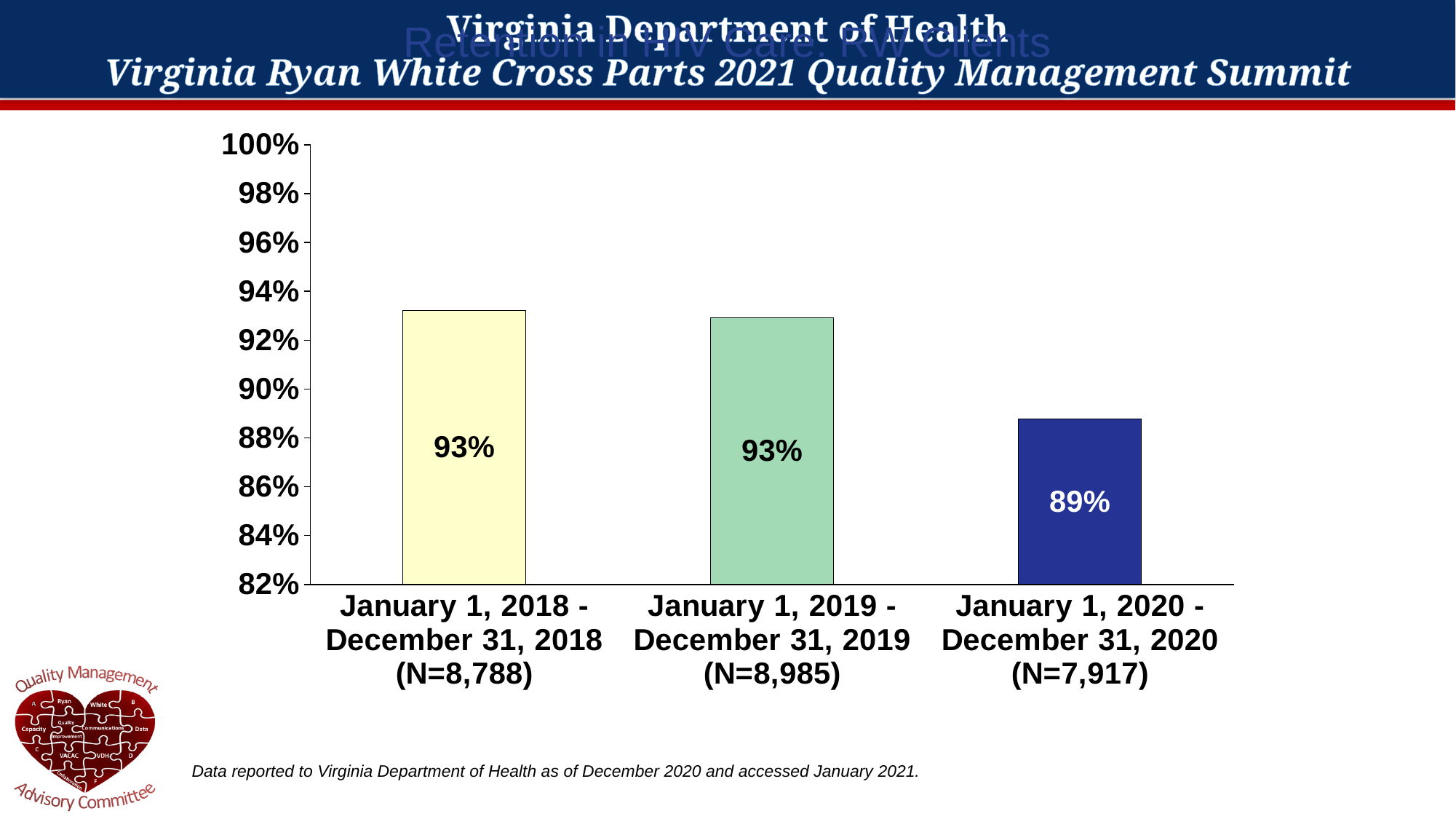
Do the values rise or fall from the 2019 period to the 2020 period? fall Which is larger, the value for the 2019 period or the value for the 2020 period? January 1, 2019 - December 31, 2019 (N=8,985) What colour is the bar for the 2020 period? dark blue What is the value for January 1, 2020 - December 31, 2020 (N=7,917)? 89% Is the value for the 2020 period greater or less than 90%? less Which period has the lowest value? January 1, 2020 - December 31, 2020 (N=7,917) What is the value for January 1, 2019 - December 31, 2019 (N=8,985)? 93% What is the value for January 1, 2018 - December 31, 2018 (N=8,788)? 93% What kind of chart is shown on the slide? bar chart What is the difference between the value for the 2018 period and the value for the 2020 period? 4 percentage points Is the value for the 2018 period greater or less than 92%? greater How many periods are shown on the chart? 3